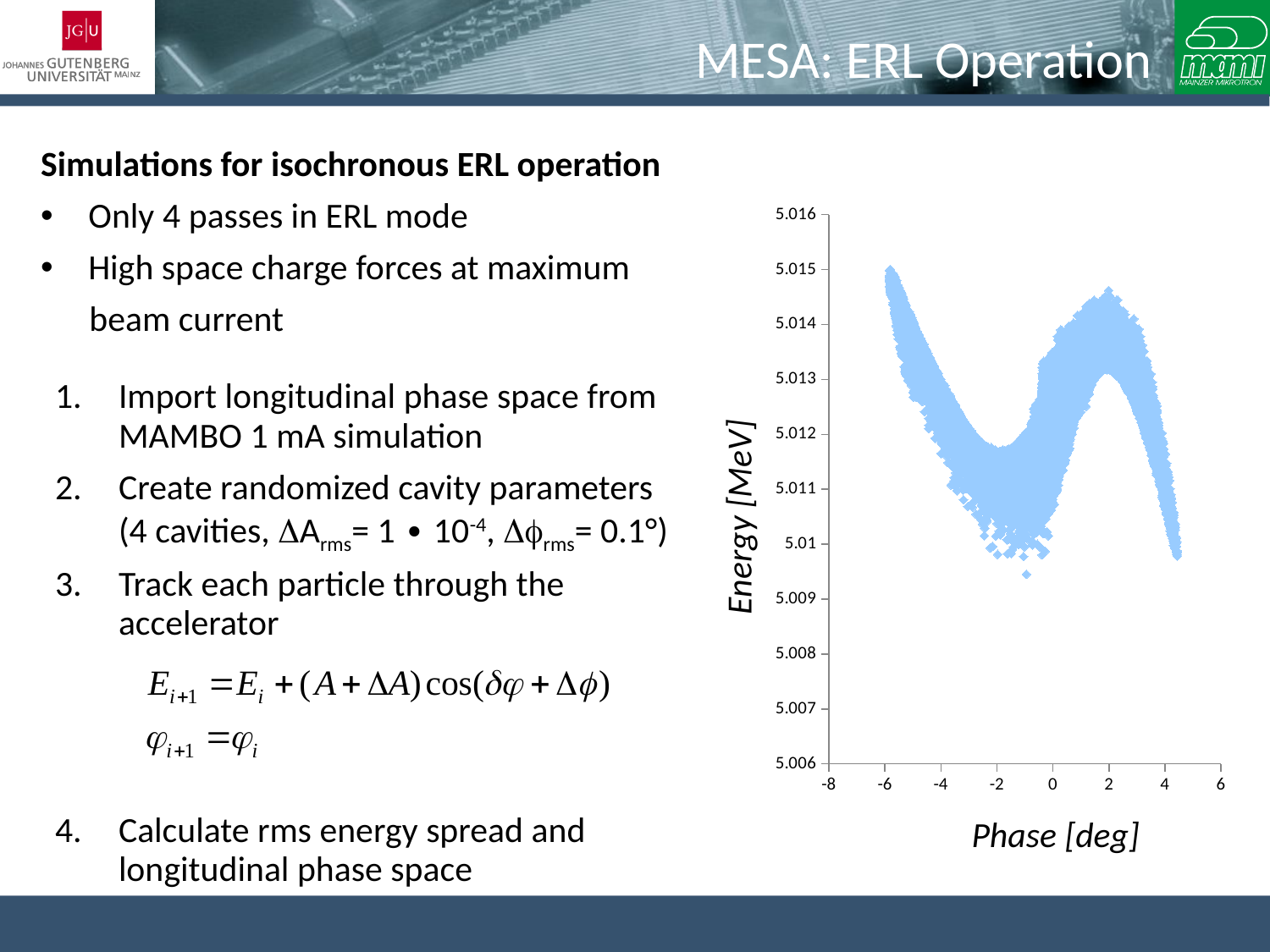
What is the label of the horizontal axis of the chart? Phase [deg] Does the energy rise or fall as the phase goes from 2 deg to 4 deg? fall Does the energy rise or fall as the phase goes from -6 deg to -2 deg? fall What kind of chart is shown on the slide? scatter plot Does the energy rise or fall as the phase goes from -2 deg to 2 deg? rise What is the label of the vertical axis of the chart? Energy [MeV] Is the energy of the particles at a phase of -4 deg greater or less than 5.011 MeV? greater Is the energy of the particles at a phase of 4 deg greater or less than 5.013 MeV? less Is the energy of the particles at a phase of 2 deg greater or less than 5.012 MeV? greater